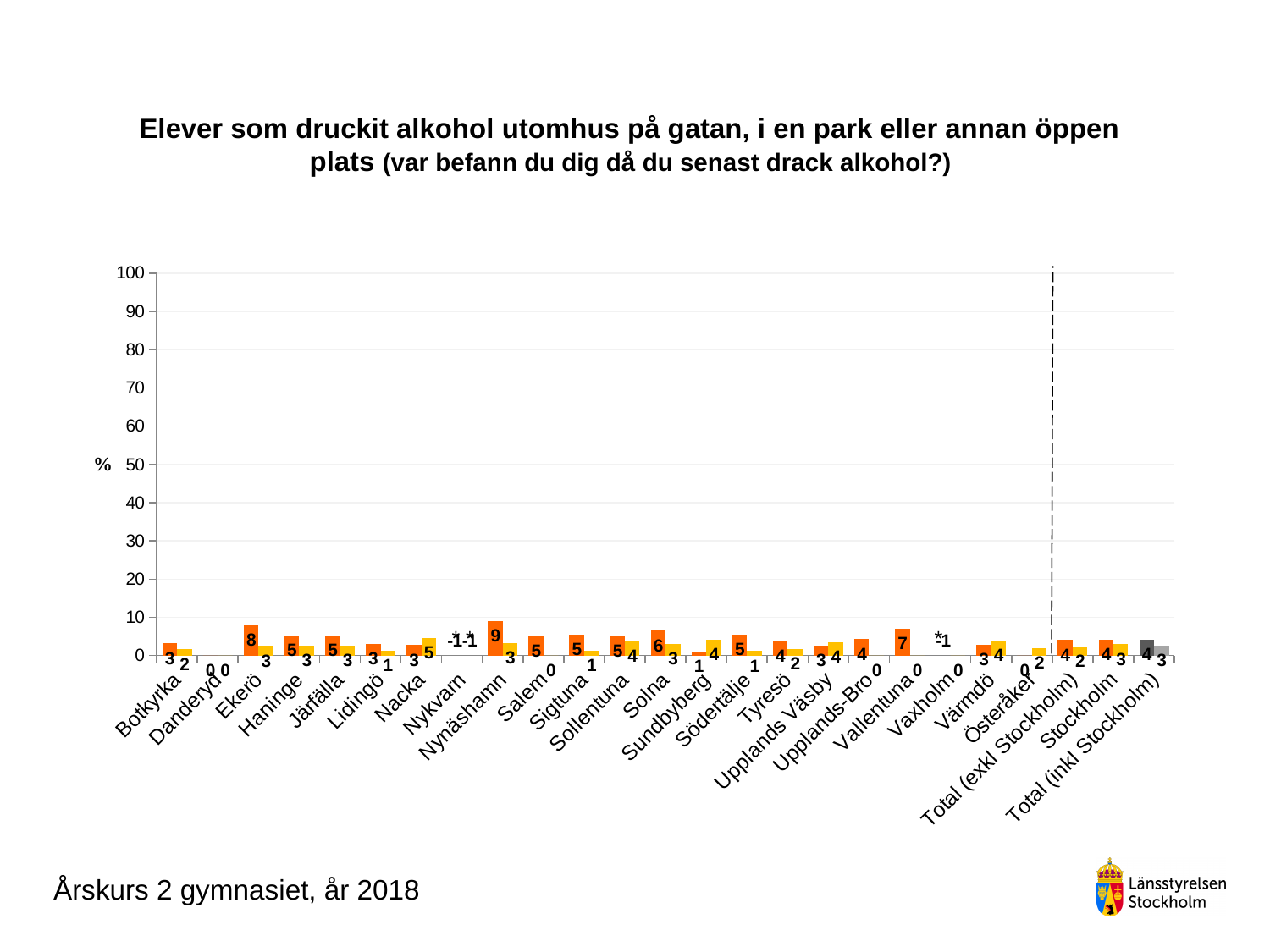
For Nacka, which bar is larger, the orange or the yellow one? yellow What is the difference between the orange and yellow bars for Ekerö? 5 How many categories are shown on the x axis? 25 What is the value of the orange bar for Vallentuna? 7 What kind of chart is shown on the slide? bar chart What is the label on the y axis? % Is the value of the orange bar for Nynäshamn greater or less than 10? less What is the value of the orange bar for Ekerö? 8 What is the value of the orange bar for Nynäshamn? 9 What is the value of the yellow bar for Sollentuna? 4 Which category has the highest orange bar? Nynäshamn